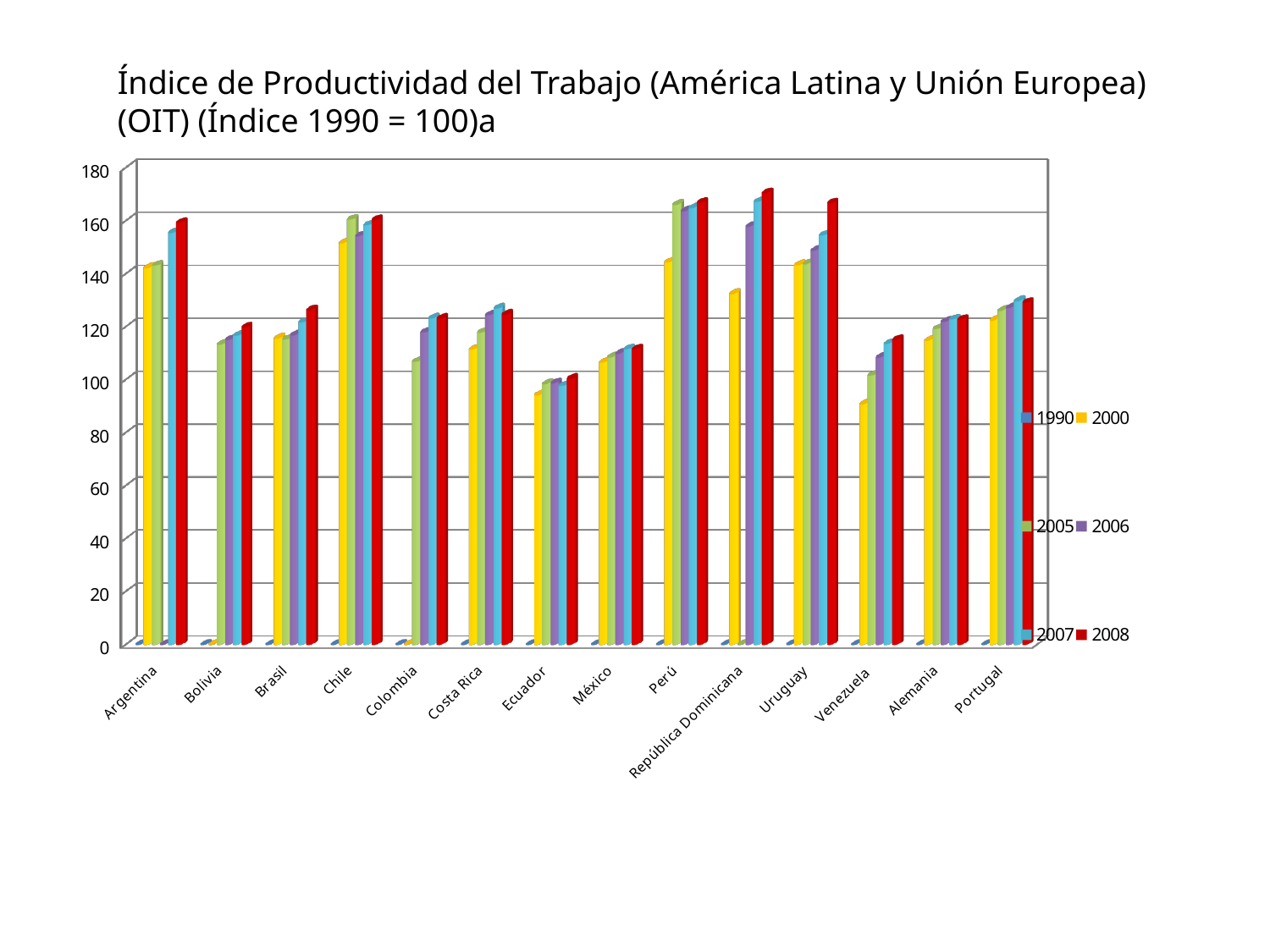
Is the 2000 value for Chile greater or less than 140? greater How many countries are shown on the x axis of the chart? 14 Is the 2008 value for Argentina greater or less than 140? greater What kind of chart is shown on the slide? bar chart Which years are listed in the chart's legend? 1990, 2000, 2005, 2006, 2007, 2008 How many series does the chart's legend list? 6 Which country has the lowest 2008 value? Ecuador What is the title of the chart? Índice de Productividad del Trabajo (América Latina y Unión Europea) (OIT) (Índice 1990 = 100)a Is the 2000 value for Venezuela greater or less than 100? less Which is larger, the 2008 value for Argentina or the 2008 value for Brasil? Argentina